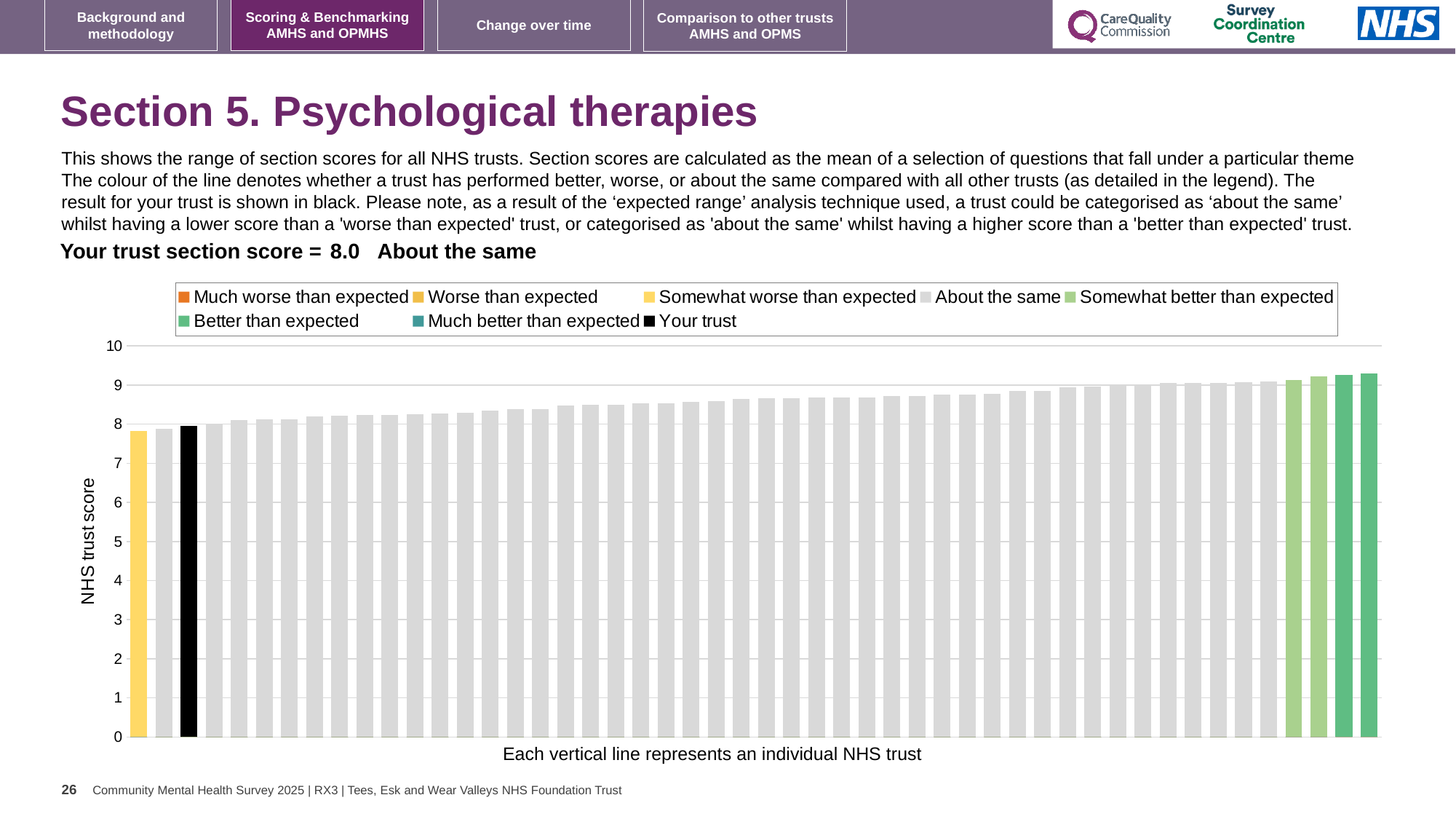
Which category is your trust placed in for this section? About the same What kind of chart is shown on the slide? bar chart How many entries does the chart legend list? 8 Is the value of the rightmost bar greater or less than 9? greater Is the value of the leftmost bar greater or less than 9? less Is the value of the black 'Your trust' bar greater or less than 7? greater Which bar is the highest: the leftmost bar or the rightmost bar? the rightmost bar How many bars are coloured as 'Somewhat better than expected' (light green)? 2 What colour is the bar representing your trust? black Do the bar values rise or fall from left to right along the x axis? rise What is the label on the y axis of the chart? NHS trust score What is the section score for your trust shown on the slide? 8.0